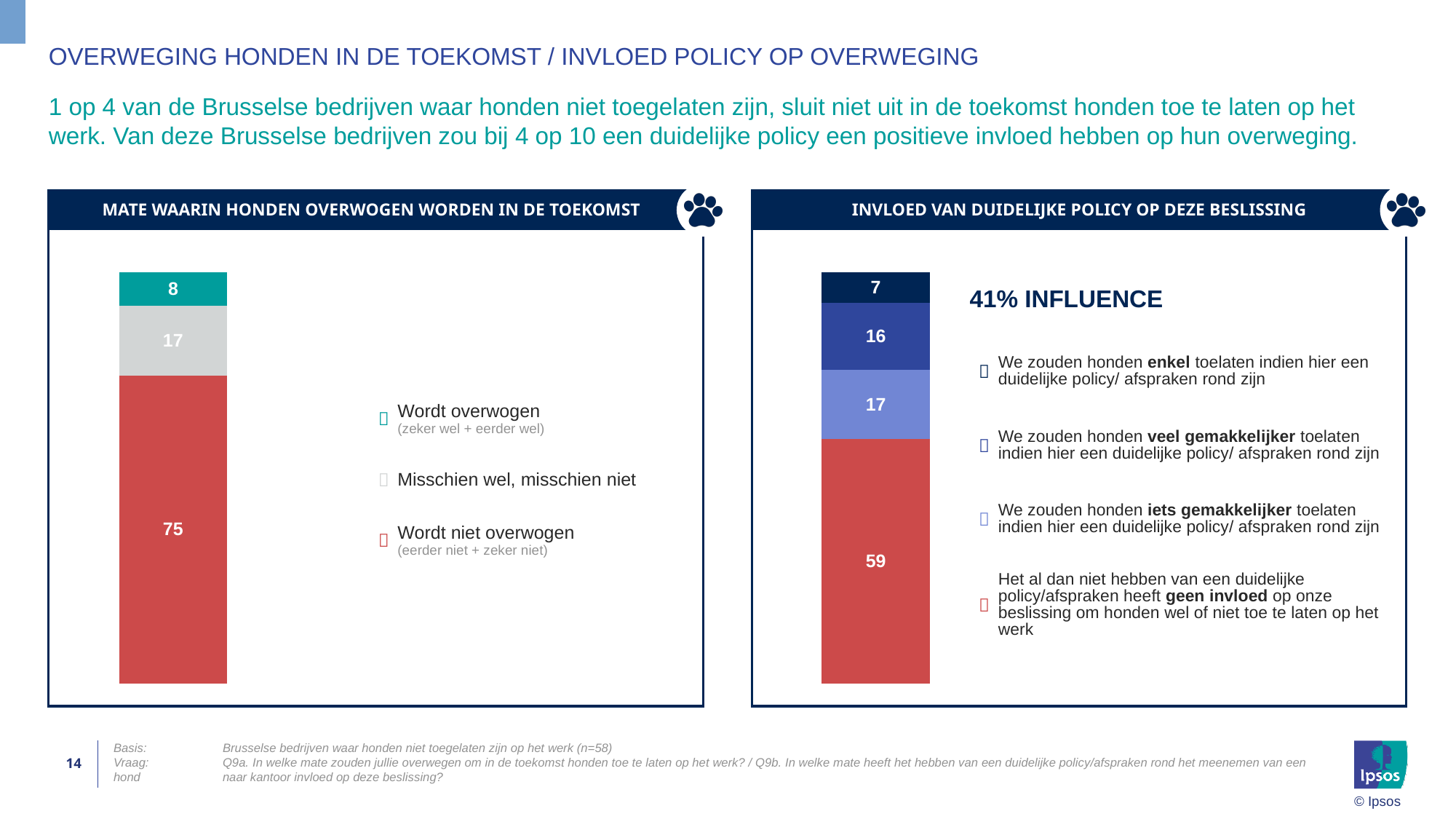
In the chart 'INVLOED VAN DUIDELIJKE POLICY OP DEZE BESLISSING', what is the value for the segment 'geen invloed'? 59 In the chart 'MATE WAARIN HONDEN OVERWOGEN WORDEN IN DE TOEKOMST', which segment has the largest value? Wordt niet overwogen In the chart 'INVLOED VAN DUIDELIJKE POLICY OP DEZE BESLISSING', which segment has the smallest value? We zouden honden enkel toelaten indien hier een duidelijke policy/ afspraken rond zijn In the chart 'INVLOED VAN DUIDELIJKE POLICY OP DEZE BESLISSING', what is the total of the three segments other than 'geen invloed' (7, 16 and 17)? 40 In the chart 'MATE WAARIN HONDEN OVERWOGEN WORDEN IN DE TOEKOMST', what is the difference between 'Wordt niet overwogen' and 'Wordt overwogen'? 67 In the chart 'MATE WAARIN HONDEN OVERWOGEN WORDEN IN DE TOEKOMST', what is the value for 'Wordt niet overwogen'? 75 In the chart 'INVLOED VAN DUIDELIJKE POLICY OP DEZE BESLISSING', how many segments make up the stacked bar? 4 In the chart 'INVLOED VAN DUIDELIJKE POLICY OP DEZE BESLISSING', what is the value for 'We zouden honden enkel toelaten indien hier een duidelijke policy/ afspraken rond zijn'? 7 What type of chart is shown in 'INVLOED VAN DUIDELIJKE POLICY OP DEZE BESLISSING'? Stacked bar chart In the chart 'MATE WAARIN HONDEN OVERWOGEN WORDEN IN DE TOEKOMST', how many segments make up the stacked bar? 3 In the chart 'MATE WAARIN HONDEN OVERWOGEN WORDEN IN DE TOEKOMST', what is the value for 'Wordt overwogen'? 8 In the chart 'MATE WAARIN HONDEN OVERWOGEN WORDEN IN DE TOEKOMST', what is the value for 'Misschien wel, misschien niet'? 17